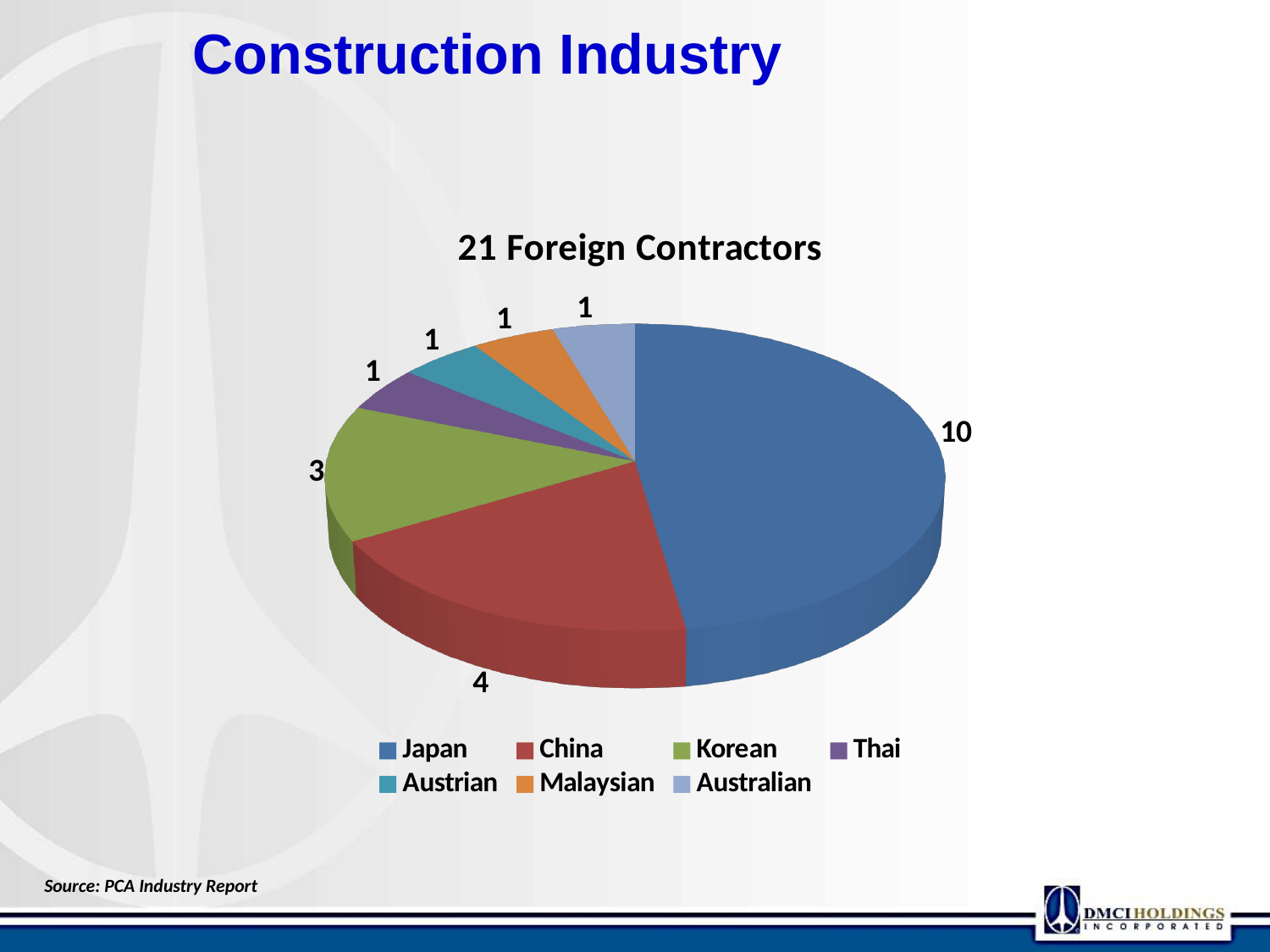
What is the total of all the slice values in the pie? 21 What is the title of the chart? 21 Foreign Contractors What is the value for the Korean slice? 3 Which colour represents Malaysian in the chart? Orange What share of the 21 foreign contractors does Japan represent? 10/21 What is the difference between the Japan and China values? 6 Which is larger, the China slice or the Korean slice? China What kind of chart is shown on the slide? Pie chart Which country has the largest slice of the pie? Japan How many foreign contractors are from China? 4 How many categories does the legend list? 7 How many foreign contractors are from Japan? 10